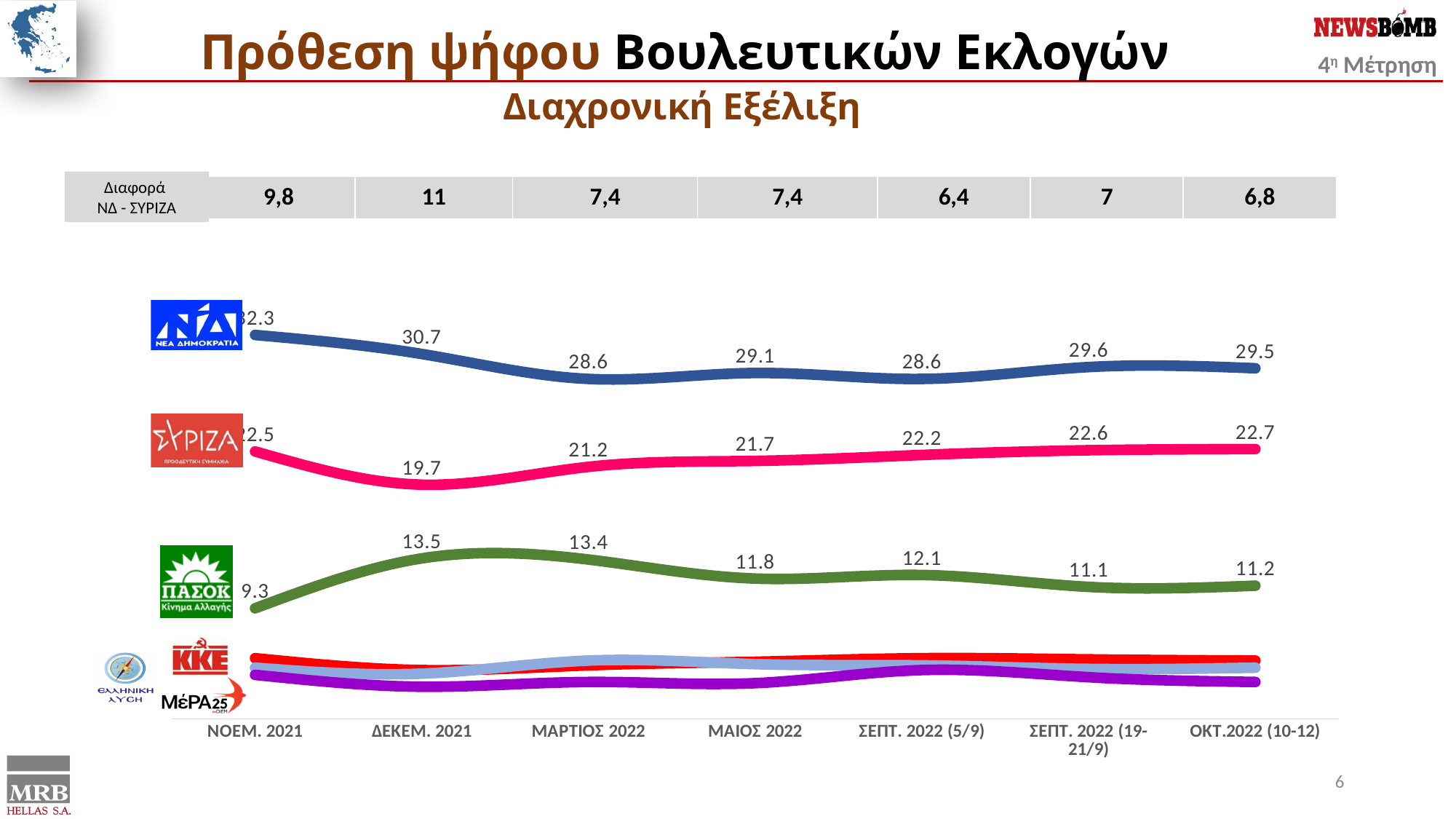
What is the difference between the ΝΔ value and the ΣΥΡΙΖΑ value in ΟΚΤ.2022 (10-12)? 6.8 What is the value for ΝΔ (Νέα Δημοκρατία) in ΝΟΕΜ. 2021? 32.3 What is the value for ΣΥΡΙΖΑ in ΔΕΚΕΜ. 2021? 19.7 Does the ΣΥΡΙΖΑ line rise or fall from ΔΕΚΕΜ. 2021 to ΟΚΤ.2022 (10-12)? Rise What kind of chart is shown on the slide? Line chart At which time point does ΠΑΣΟΚ reach its highest value? ΔΕΚΕΜ. 2021 What is the value for ΠΑΣΟΚ in ΟΚΤ.2022 (10-12)? 11.2 In the 'Διαφορά ΝΔ - ΣΥΡΙΖΑ' row above the chart, what is the value for the second measurement (ΔΕΚΕΜ. 2021)? 11 Which is larger in ΜΑΡΤΙΟΣ 2022: the ΠΑΣΟΚ value or the ΣΥΡΙΖΑ value? ΣΥΡΙΖΑ How many time points are shown on the x axis of the chart? 7 What is the value for ΝΔ in ΣΕΠΤ. 2022 (19-21/9)? 29.6 At which time point does ΣΥΡΙΖΑ have its lowest value? ΔΕΚΕΜ. 2021